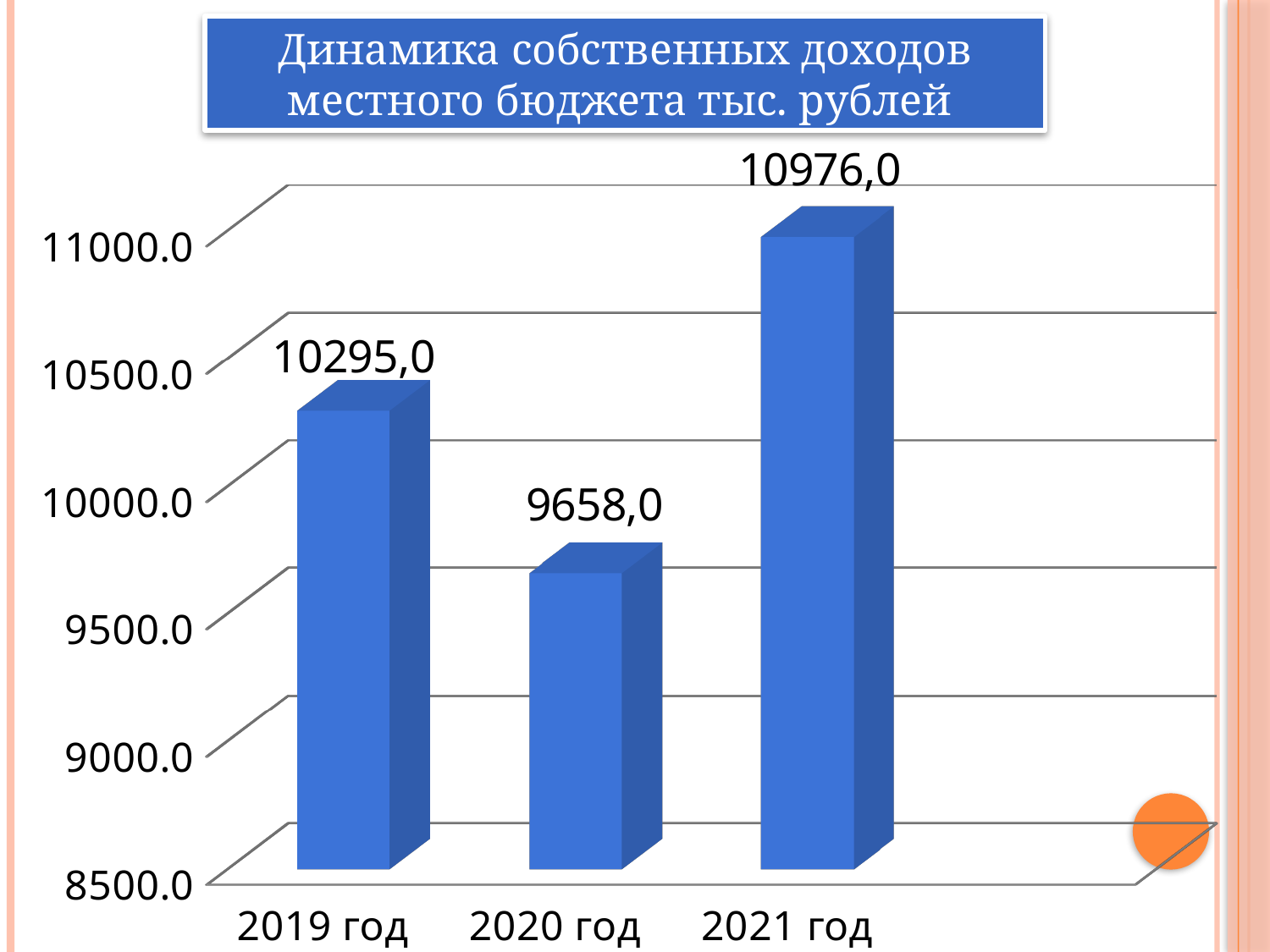
What is the difference between the values for 2021 год and 2019 год? 681,0 What is the value for 2021 год? 10976,0 Is the value for 2020 год greater or less than 10000.0? less Which year has the highest value? 2021 год Which is larger, the value for 2019 год or the value for 2020 год? 2019 год What is the value for 2019 год? 10295,0 How many years are shown on the chart? 3 Which year has the lowest value? 2020 год What kind of chart is shown on the slide? bar chart What is the title of the chart? Динамика собственных доходов местного бюджета тыс. рублей What is the value for 2020 год? 9658,0 What is the difference between the values for 2019 год and 2020 год? 637,0